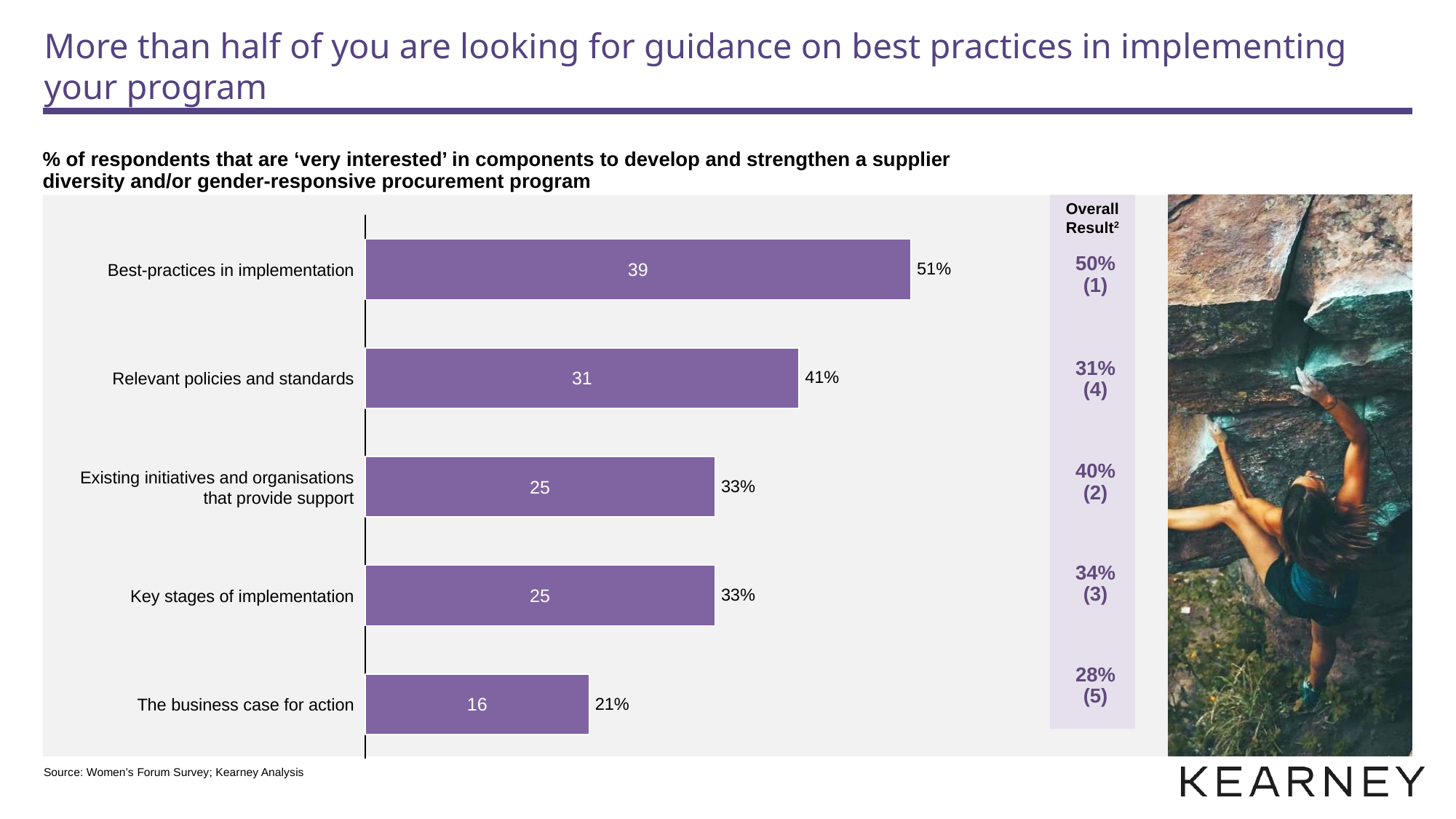
What is the difference in percentage points between 'Best-practices in implementation' and 'Relevant policies and standards'? 10 Which component has the lowest percentage of 'very interested' respondents? The business case for action What is the Overall Result percentage shown for 'Existing initiatives and organisations that provide support'? 40% Which has a larger percentage: 'Relevant policies and standards' or 'Key stages of implementation'? Relevant policies and standards What is the difference between the counts for 'Best-practices in implementation' and 'The business case for action'? 23 What percentage of respondents are 'very interested' in best-practices in implementation? 51% What is the count shown inside the bar for 'Relevant policies and standards'? 31 Which component has the highest percentage of 'very interested' respondents? Best-practices in implementation How many components (categories) are shown in the bar chart? 5 What kind of chart is shown on the slide? Bar chart What percentage is shown for 'The business case for action'? 21% What is the Overall Result rank shown for 'Relevant policies and standards'? (4)